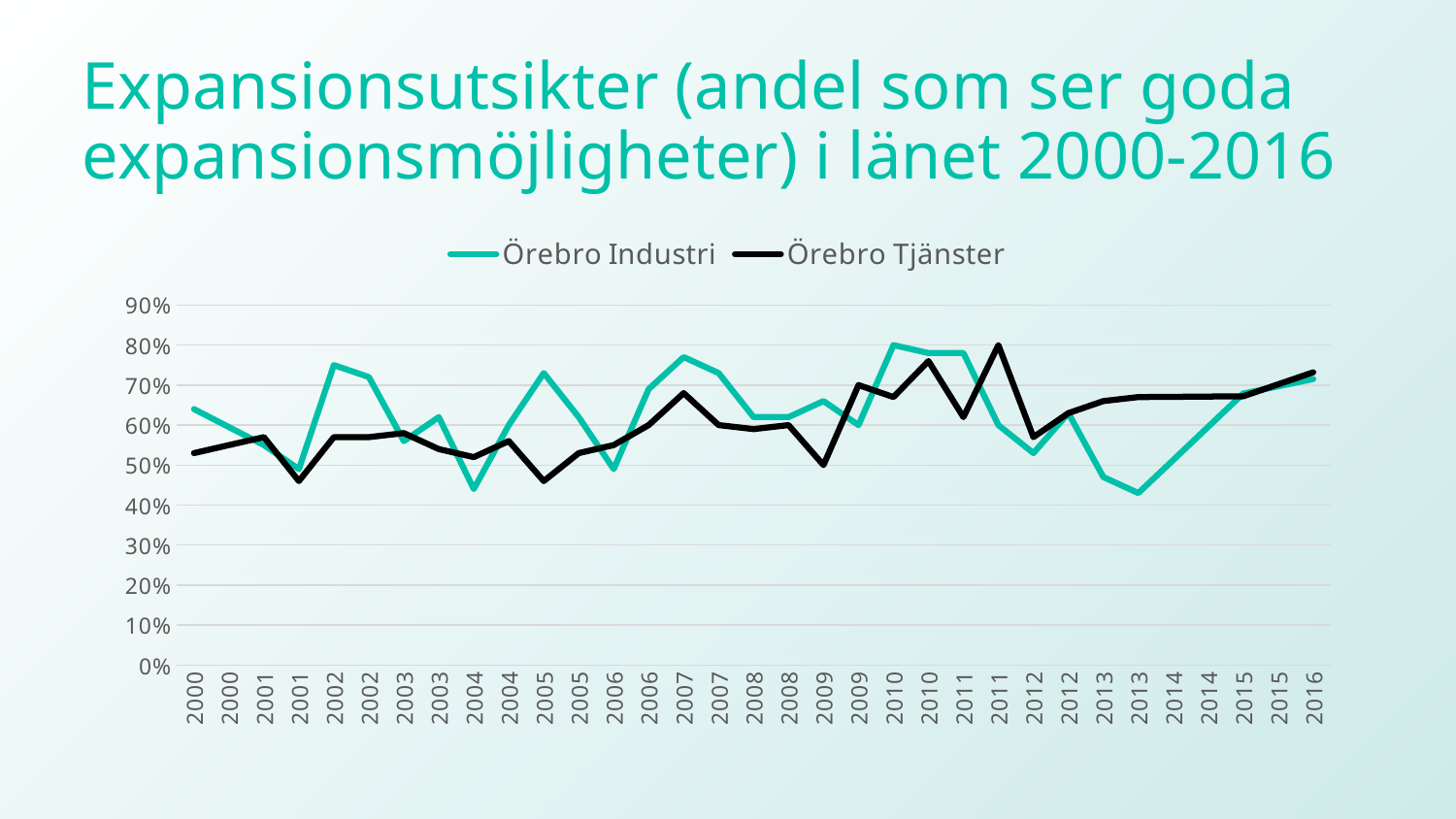
Is the value for Örebro Industri at the first 2002 point greater or less than 70%? greater Which colour is the Örebro Tjänster line? black Does the Örebro Tjänster line rise or fall from the second 2012 point to 2016? rise Is the value for Örebro Tjänster at the second 2011 point greater or less than 70%? greater Is the value for Örebro Industri at the second 2013 point greater or less than 50%? less At the second 2013 point, which series has the higher value, Örebro Industri or Örebro Tjänster? Örebro Tjänster At the first 2002 point, which series has the higher value, Örebro Industri or Örebro Tjänster? Örebro Industri How many series does the legend list? 2 What kind of chart is shown on the slide? line chart Which two series are shown in the legend? Örebro Industri and Örebro Tjänster